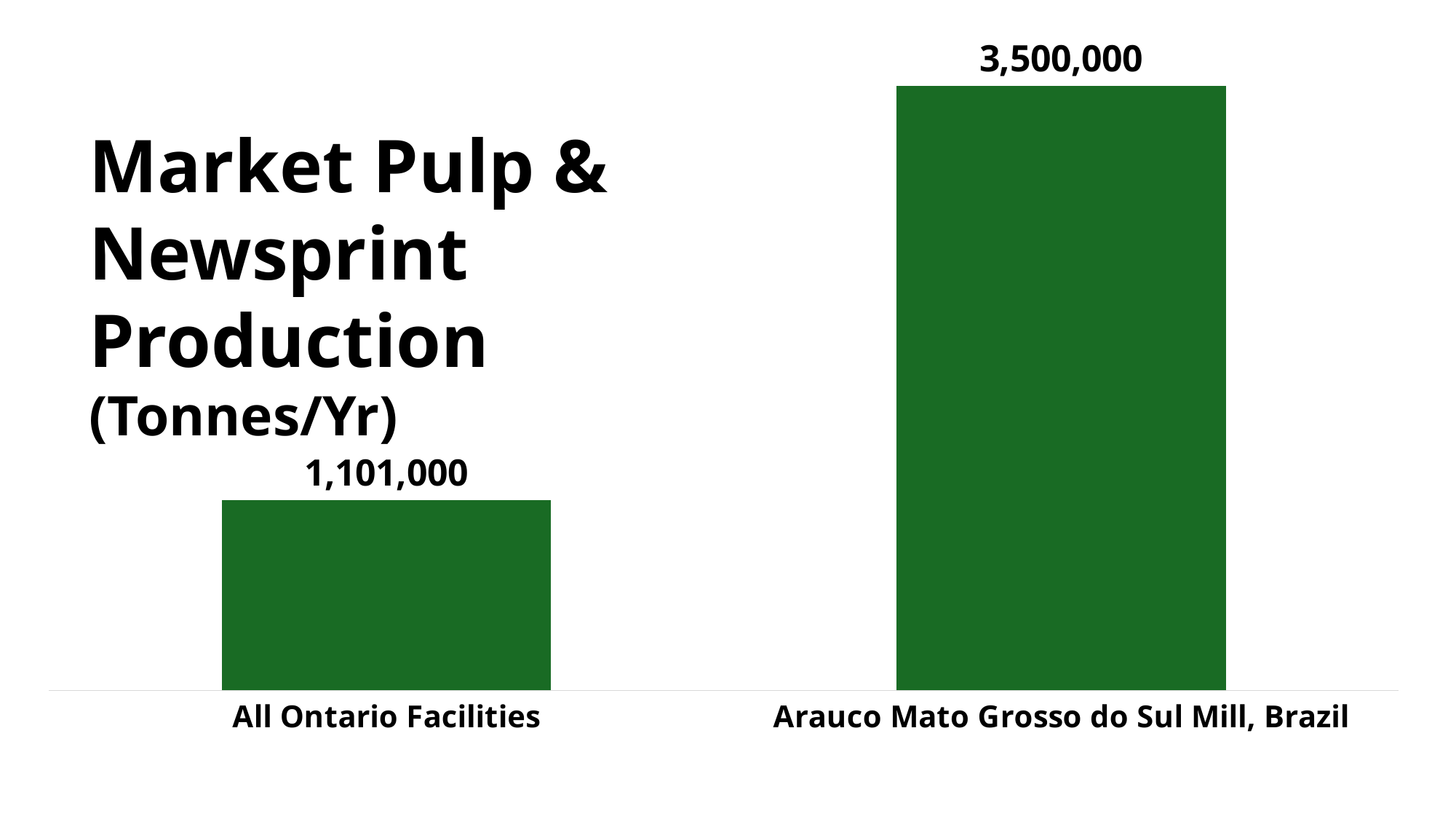
What is the combined production of All Ontario Facilities and the Arauco Mato Grosso do Sul Mill, Brazil? 4,601,000 Which category has the lowest production value? All Ontario Facilities What is the difference in production between the Arauco Mato Grosso do Sul Mill, Brazil and All Ontario Facilities? 2,399,000 Which category has the highest production value? Arauco Mato Grosso do Sul Mill, Brazil What unit is the production measured in, according to the chart title? Tonnes/Yr How many categories are shown in the chart? 2 Which is larger: the production of All Ontario Facilities or the Arauco Mato Grosso do Sul Mill, Brazil? Arauco Mato Grosso do Sul Mill, Brazil What is the title of the chart? Market Pulp & Newsprint Production (Tonnes/Yr) What kind of chart is shown on the slide? Bar chart What is the market pulp and newsprint production value for All Ontario Facilities? 1,101,000 What is the market pulp and newsprint production value for the Arauco Mato Grosso do Sul Mill, Brazil? 3,500,000